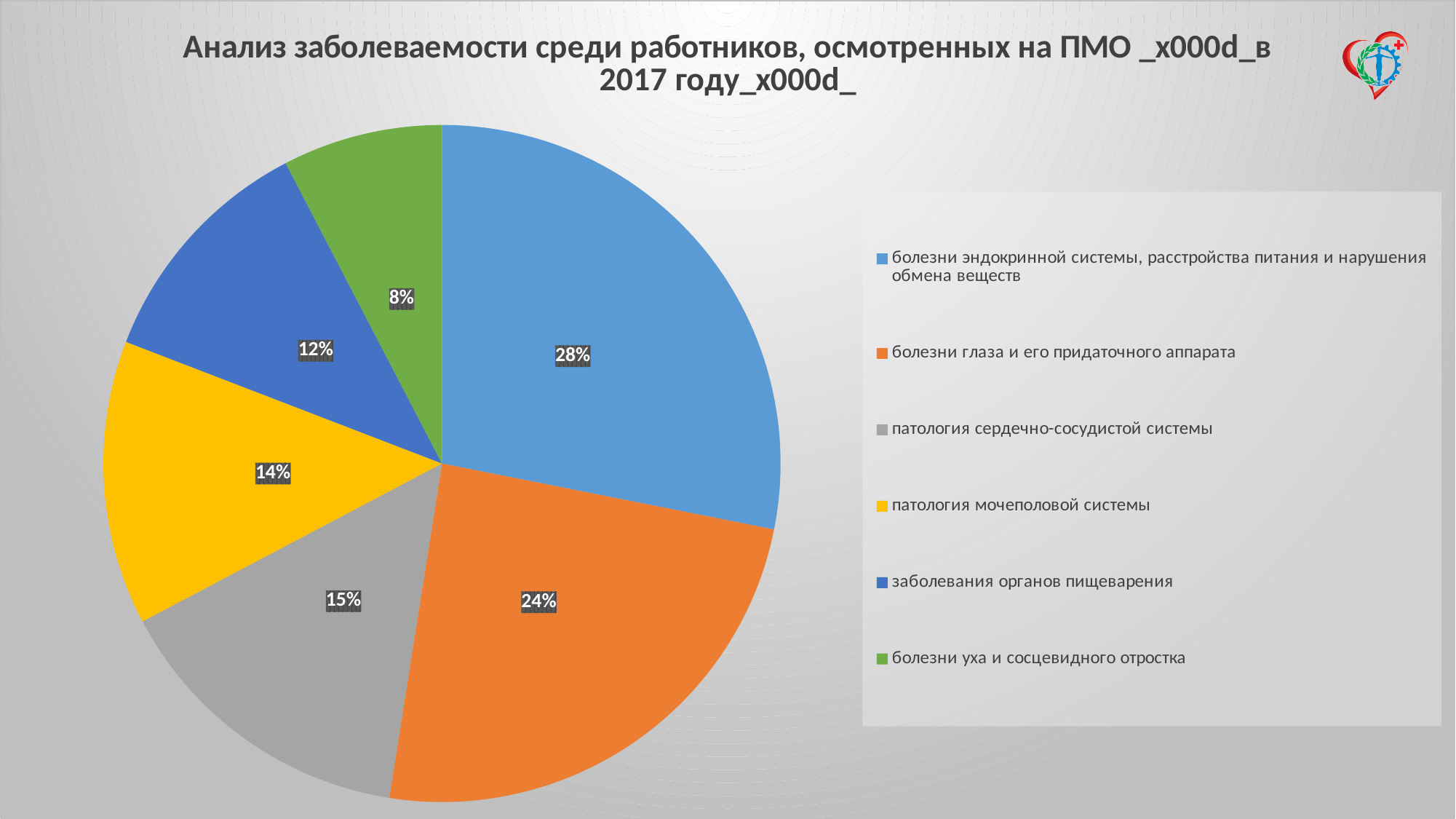
What is the value shown for 'патология сердечно-сосудистой системы'? 15% What colour is the slice for 'патология мочеполовой системы'? yellow What is the difference in percentage points between 'болезни эндокринной системы, расстройства питания и нарушения обмена веществ' and 'болезни глаза и его придаточного аппарата'? 4 Which category has the largest slice of the pie? болезни эндокринной системы, расстройства питания и нарушения обмена веществ What share of the pie is 'болезни глаза и его придаточного аппарата'? 24% How many slices does the pie chart have? 6 What is the value shown for 'заболевания органов пищеварения'? 12% What is the value shown for 'патология мочеполовой системы'? 14% What share of the pie is 'болезни эндокринной системы, расстройства питания и нарушения обмена веществ'? 28% Which category has the smallest slice of the pie? болезни уха и сосцевидного отростка What kind of chart is shown on the slide? pie chart Which is larger: the slice for 'патология сердечно-сосудистой системы' or the slice for 'болезни уха и сосцевидного отростка'? патология сердечно-сосудистой системы